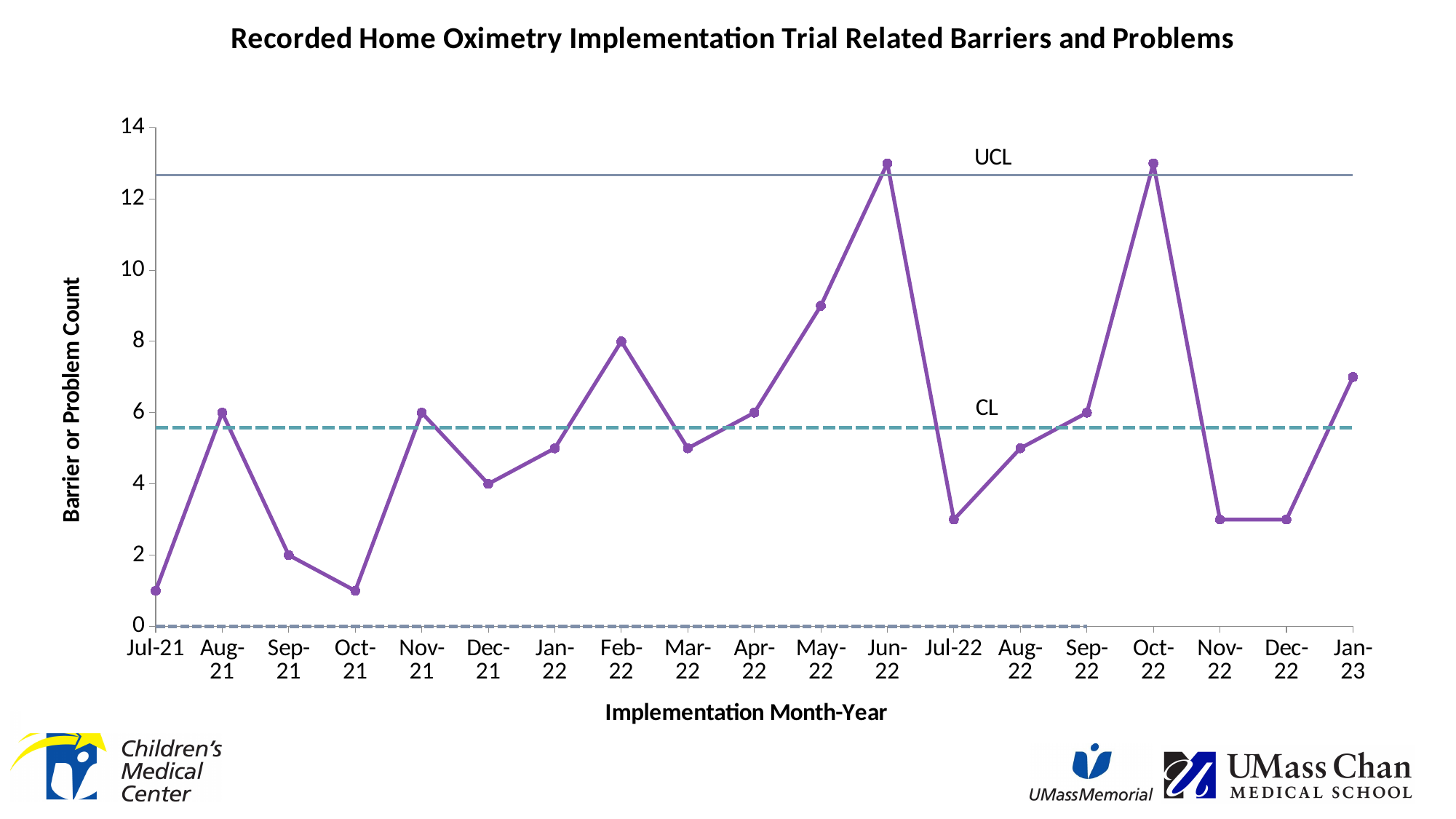
What is the label on the solid horizontal line near the top of the chart? UCL What type of chart is shown on the slide? line chart What is the barrier or problem count for Aug-21? 6 What is the barrier or problem count for Feb-22? 8 How many months are plotted on the x axis? 19 What is the difference between the barrier or problem counts for Feb-22 and Dec-21? 4 Is the value for Jun-22 greater or less than 12? greater Is the value for Jul-22 greater or less than 4? less Which has a higher barrier or problem count, Feb-22 or Dec-21? Feb-22 What is the barrier or problem count for Sep-21? 2 What is the title of the chart? Recorded Home Oximetry Implementation Trial Related Barriers and Problems What is the barrier or problem count for Dec-21? 4